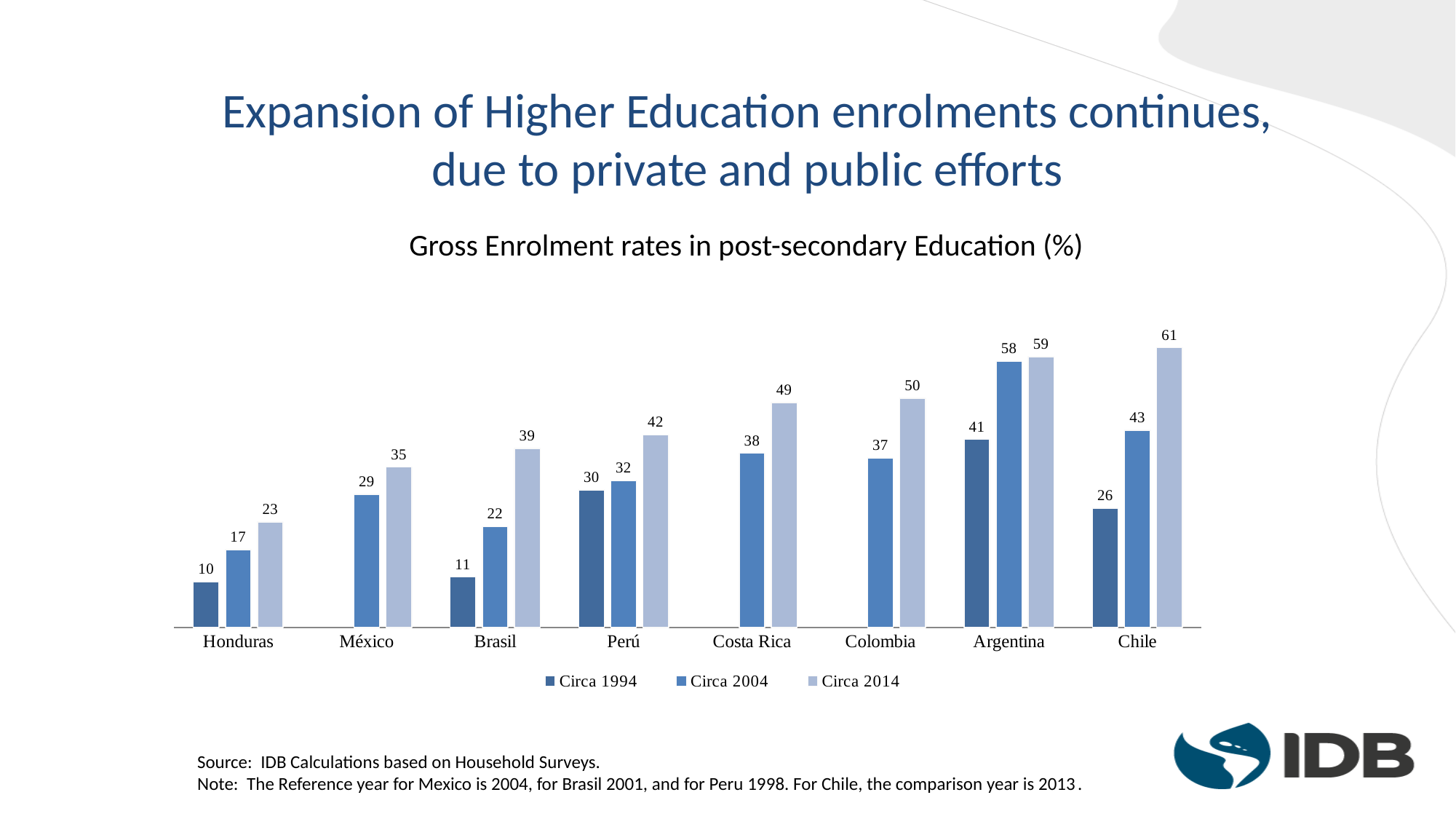
Which country has the lowest Circa 2004 value? Honduras What is the difference between the Circa 2014 and Circa 1994 values for Brasil? 28 What is the chart's title? Gross Enrolment rates in post-secondary Education (%) Which is larger for Argentina: the Circa 2004 value or the Circa 1994 value? Circa 2004 How many countries are shown on the x axis? 8 Which country has the highest Circa 2014 value? Chile For Perú, do the values rise or fall from Circa 1994 to Circa 2014? Rise What is the Circa 2014 gross enrolment rate for Chile? 61 How many series does the legend list? 3 What is the Circa 1994 gross enrolment rate for Honduras? 10 What is the Circa 2004 value for Colombia? 37 What kind of chart is shown on the slide? Bar chart